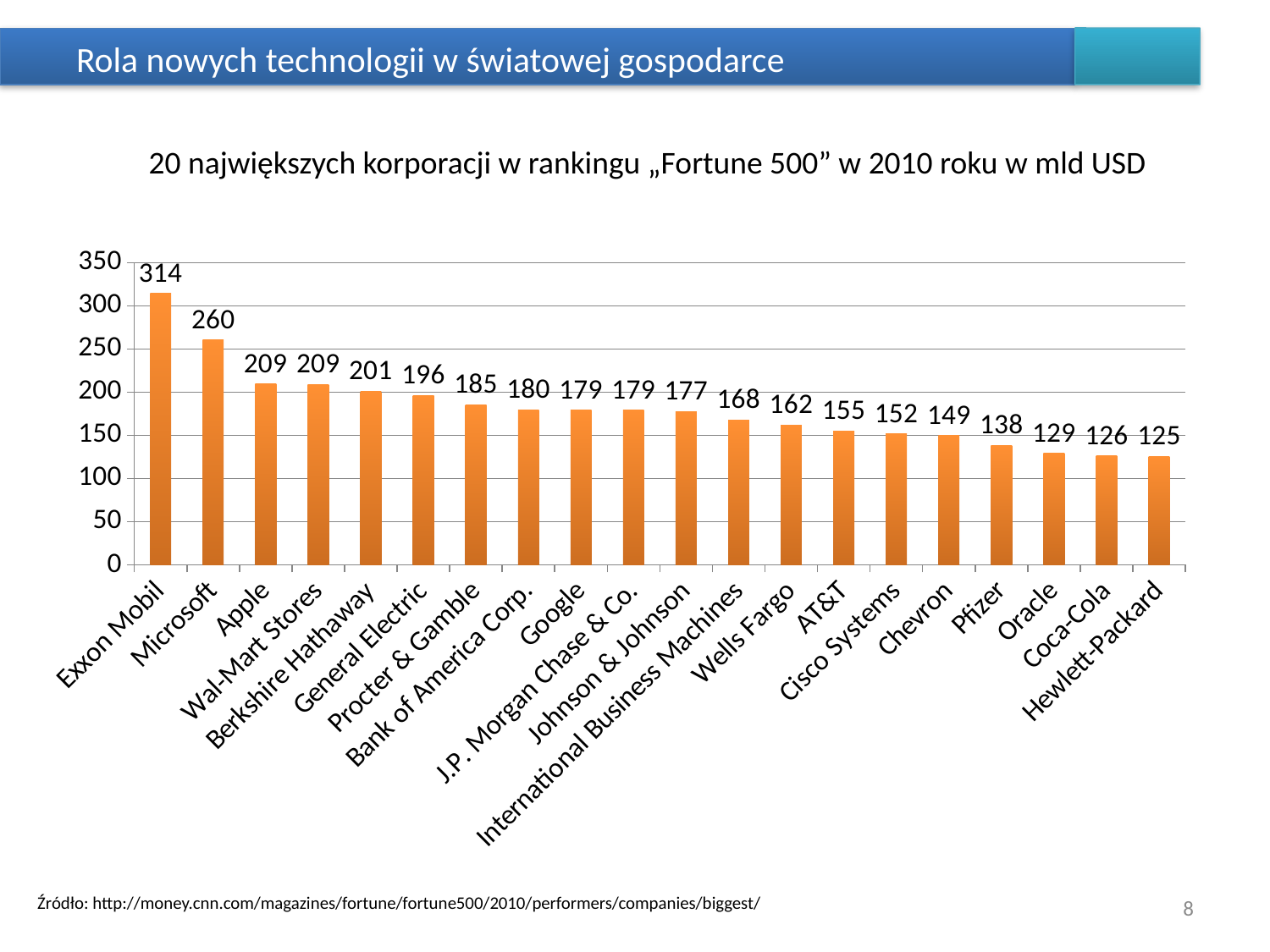
Which company has the highest value? Exxon Mobil What is the value for Hewlett-Packard? 125 Do the values rise or fall from left to right along the x axis? fall What is the value for Exxon Mobil? 314 How many companies are shown on the chart? 20 What is the title of the chart? 20 największych korporacji w rankingu „Fortune 500” w 2010 roku w mld USD What is the difference between the values for Exxon Mobil and Microsoft? 54 Which is larger, the value for Wells Fargo or the value for Chevron? Wells Fargo What is the value for Google? 179 Is the value for Pfizer greater or less than 150? less Which company has the lowest value? Hewlett-Packard What kind of chart is shown on the slide? bar chart